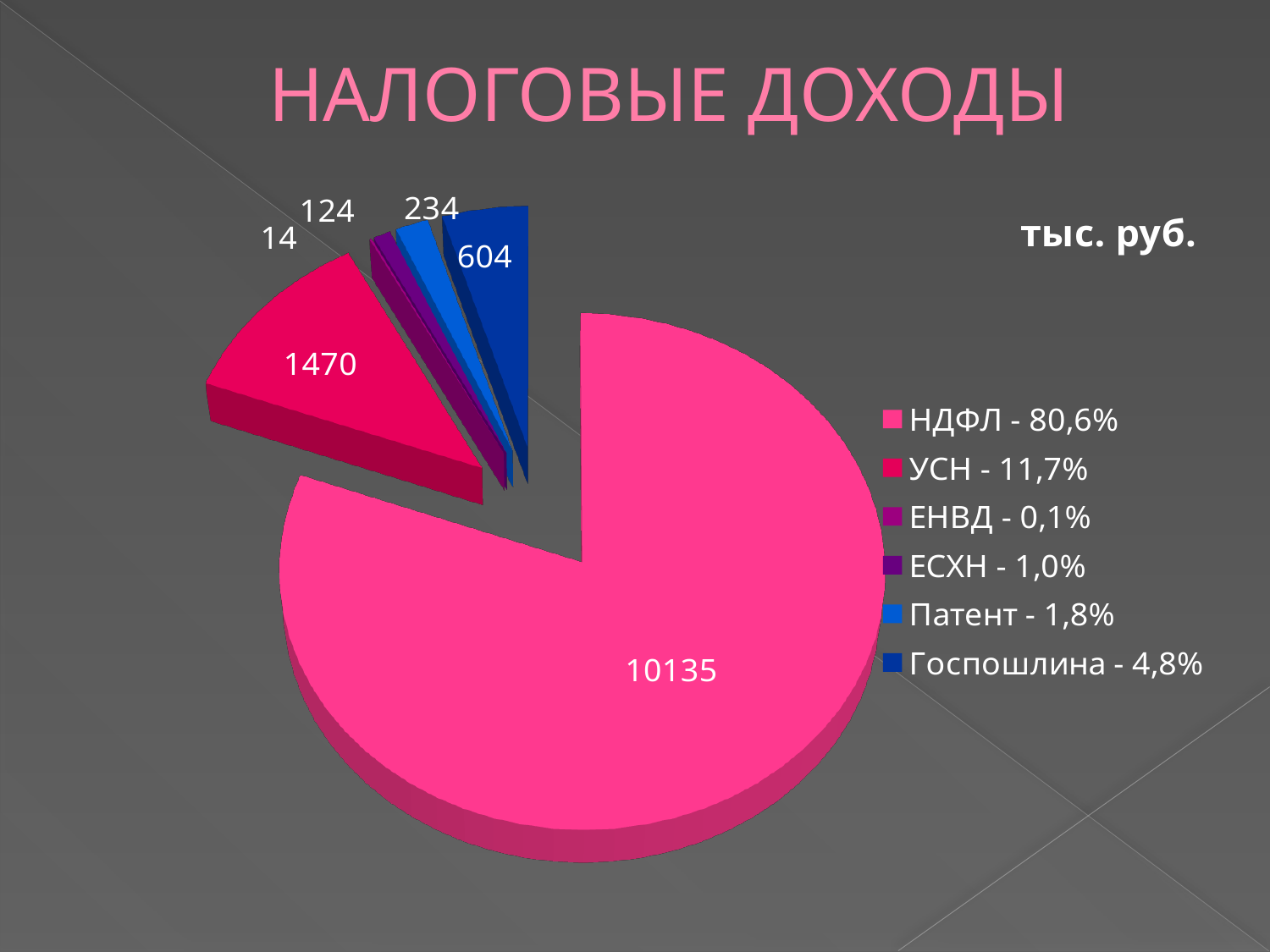
What is the value for НДФЛ? 10135 How many categories does the legend list? 6 Which category has the smallest slice of the pie? ЕНВД What is the value for Госпошлина? 604 What is the value for УСН? 1470 What kind of chart is shown on the slide? pie chart What share of the pie does УСН represent, according to the legend? 11,7% Which is larger, the value for Патент or the value for ЕСХН? Патент What is the difference between the values for УСН and Госпошлина? 866 Which category has the largest slice of the pie? НДФЛ What is the value for Патент? 234 What share of the pie does Госпошлина represent, according to the legend? 4,8%